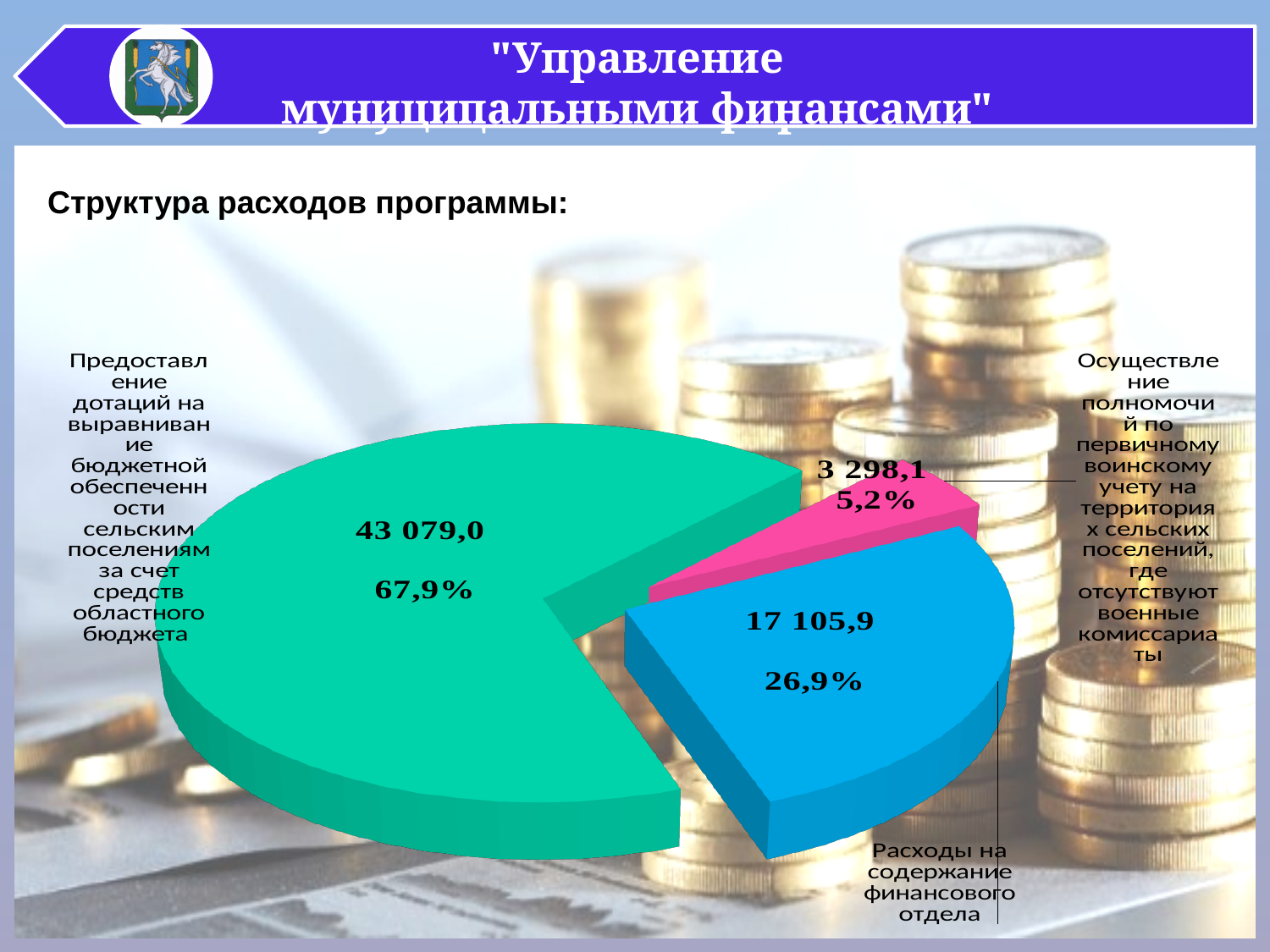
Which slice of the pie chart is the smallest? Осуществление полномочий по первичному воинскому учету Which slice of the pie chart is the largest? Предоставление дотаций на выравнивание бюджетной обеспеченности сельским поселениям за счет средств областного бюджета Which is larger: the value for 'Расходы на содержание финансового отдела' or the value for 'Осуществление полномочий по первичному воинскому учету'? Расходы на содержание финансового отдела What percentage share is shown for the slice 'Расходы на содержание финансового отдела'? 26,9% What is the value shown for the slice 'Предоставление дотаций на выравнивание бюджетной обеспеченности сельским поселениям за счет средств областного бюджета'? 43 079,0 What kind of chart is shown on the slide? pie chart What is the value shown for the slice 'Расходы на содержание финансового отдела'? 17 105,9 What is the difference between the values for 'Предоставление дотаций...' (43 079,0) and 'Расходы на содержание финансового отдела' (17 105,9)? 25 973,1 How many slices does the pie chart have? 3 What is the heading printed above the pie chart? Структура расходов программы: What is the value shown for the slice 'Осуществление полномочий по первичному воинскому учету'? 3 298,1 What percentage share is shown for the slice 'Осуществление полномочий по первичному воинскому учету'? 5,2%